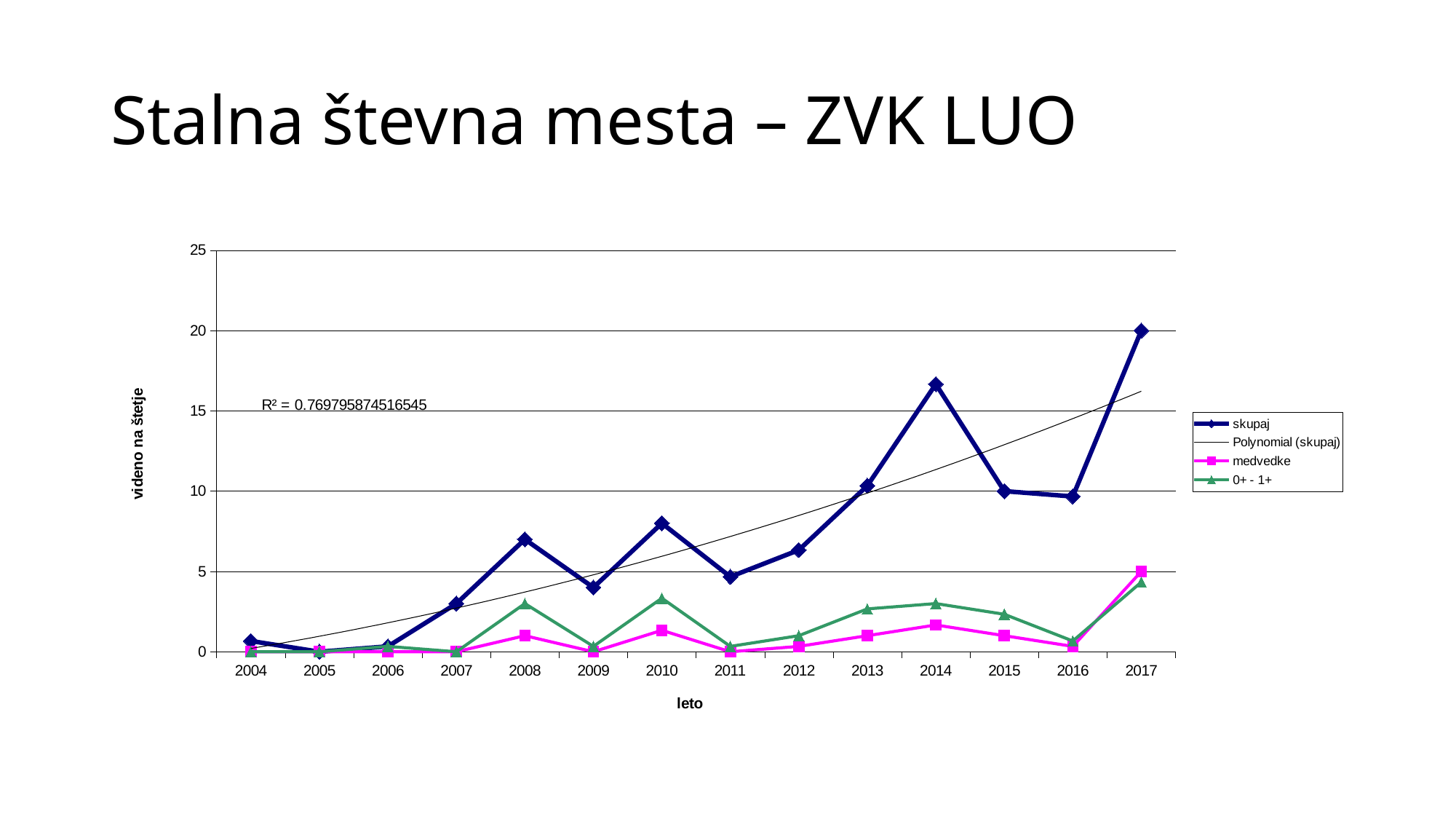
Which year has the larger skupaj value, 2008 or 2009? 2008 How many series does the legend list? 4 In which year does the skupaj series reach its highest value? 2017 What is the R² value printed on the chart? R² = 0.769795874516545 What kind of chart is shown on the slide? line chart In which year is the skupaj series at its lowest value? 2005 What is the value of the skupaj series in 2017? 20 Does the skupaj series rise or fall between 2014 and 2016? fall In 2010, which series is larger, medvedke or 0+ - 1+? 0+ - 1+ How many years are plotted along the x axis? 14 Is the value of skupaj in 2014 greater or less than 15? greater Is the value of skupaj in 2010 greater or less than 5? greater